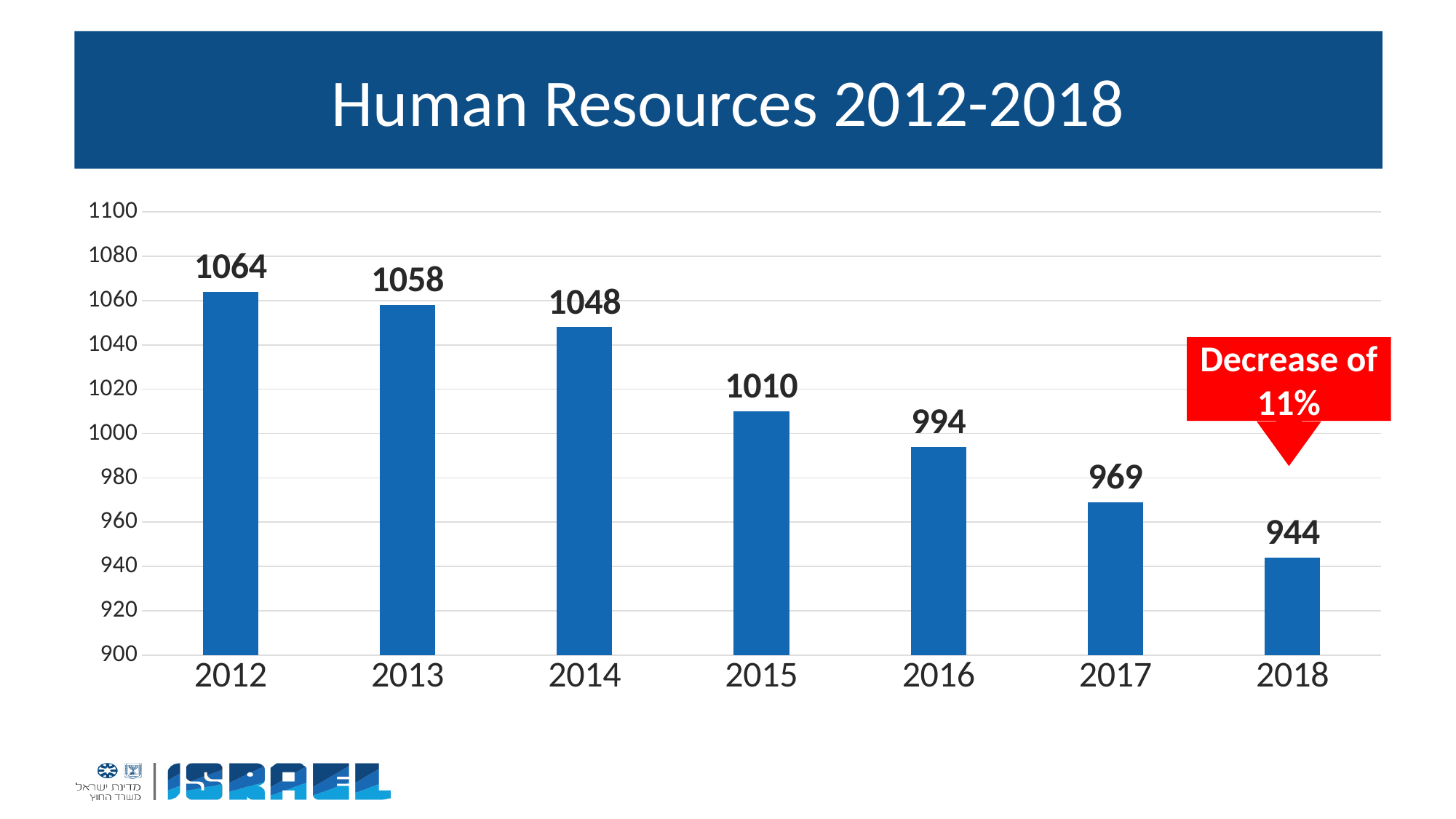
What is the value for 2018? 944 Which year has the highest value? 2012 What is the value for 2015? 1010 Which is larger, the value for 2014 or the value for 2016? 2014 Is the value for 2017 greater or less than 1000? less Which year has the lowest value? 2018 How many years are shown on the x axis? 7 What is the difference between the values for 2012 and 2018? 120 Do the values rise or fall from 2012 to 2018? fall What is the value for 2012? 1064 What is the difference between the values for 2016 and 2017? 25 What kind of chart is shown on the slide? bar chart